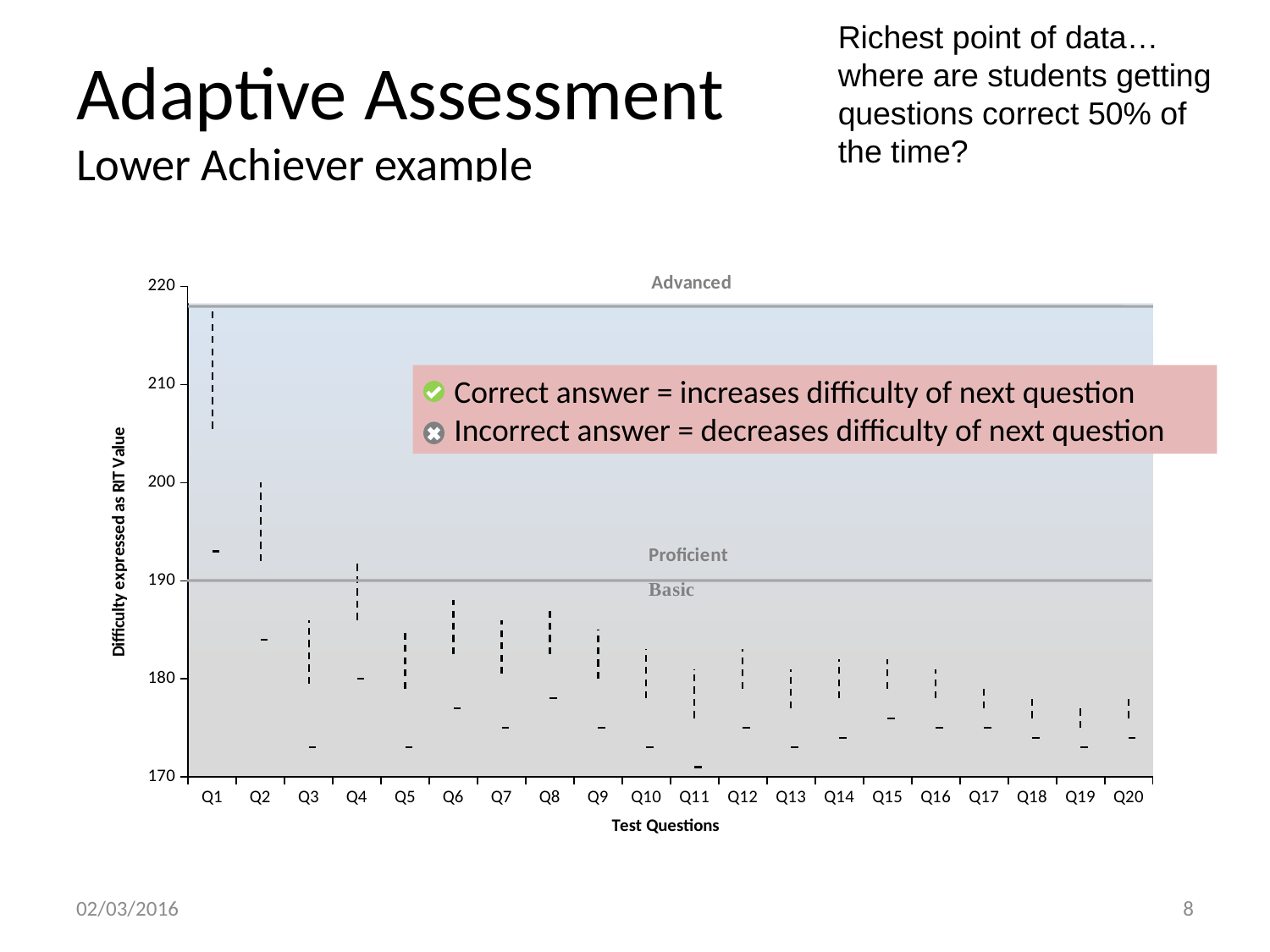
Is the highest plotted value for Q20 greater or less than 180? less How many test questions are plotted along the x axis of the chart? 20 What is the title of the vertical axis of the chart? Difficulty expressed as RIT Value Is the lowest plotted value for Q11 greater or less than 180? less Which test question reaches the highest difficulty value on the chart? Q1 Is the highest plotted value for Q6 greater or less than 190? less What is the title of the horizontal axis of the chart? Test Questions Which test question has a higher maximum plotted value, Q1 or Q10? Q1 Do the plotted difficulty values generally rise or fall from Q1 to Q20? fall Which test question has a higher maximum plotted value, Q4 or Q18? Q4